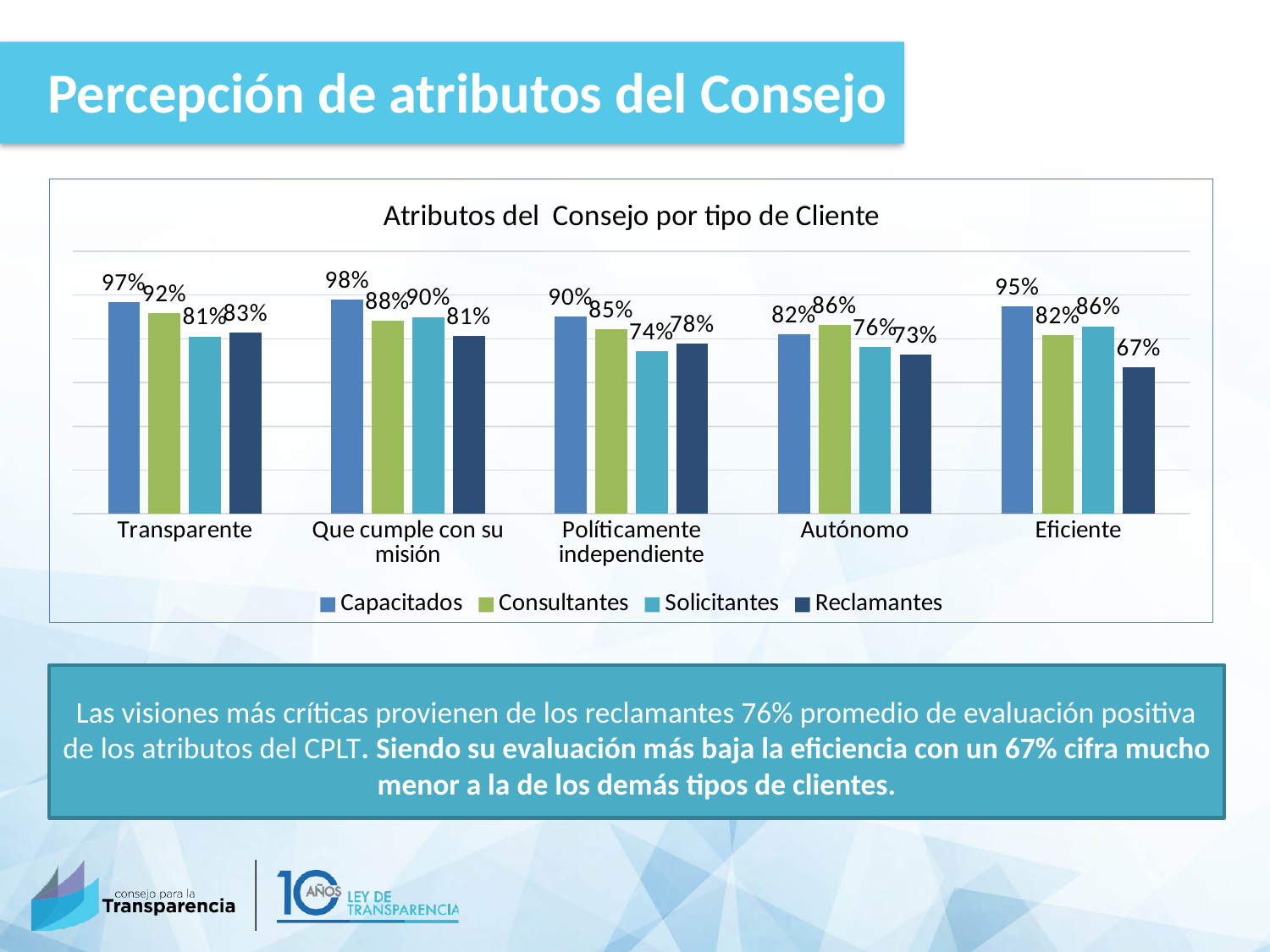
Which category has the lowest value for Reclamantes? Eficiente What is the value for Consultantes in the Autónomo category? 86% Which category has the highest value for Capacitados? Que cumple con su misión How many series does the legend list? 4 What is the value for Capacitados in the Transparente category? 97% What is the difference between the Capacitados and Reclamantes values in the Eficiente category? 28% What is the value for Reclamantes in the Eficiente category? 67% What kind of chart is shown? Bar chart In the Autónomo category, which is larger: the value for Capacitados or the value for Consultantes? Consultantes What is the title of the chart? Atributos del Consejo por tipo de Cliente How many categories are shown on the x axis? 5 What is the value for Solicitantes in the Que cumple con su misión category? 90%